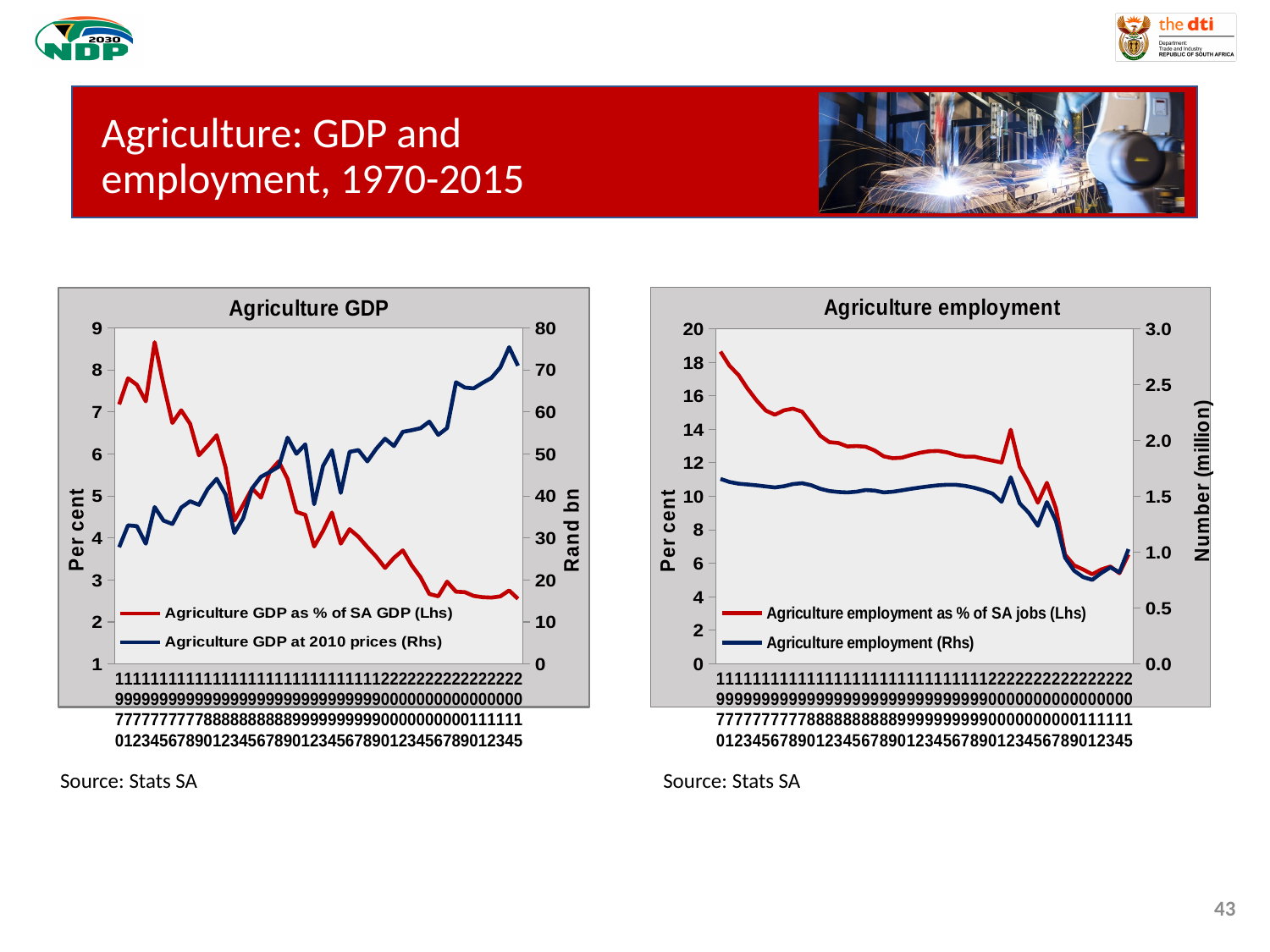
In the 'Agriculture GDP' chart, is the value of 'Agriculture GDP at 2010 prices (Rhs)' in 2015 greater or less than 60? greater How many series does the legend of the 'Agriculture GDP' chart list? 2 In the 'Agriculture employment' chart, does the 'Agriculture employment as % of SA jobs (Lhs)' series generally rise or fall from 1970 to 2015? Fall In the 'Agriculture GDP' chart, does the 'Agriculture GDP at 2010 prices (Rhs)' series generally rise or fall from 1970 to 2015? Rise How many series does the legend of the 'Agriculture employment' chart list? 2 In the 'Agriculture employment' chart, is the value of 'Agriculture employment as % of SA jobs (Lhs)' in 2015 greater or less than 8? less In the 'Agriculture GDP' chart, does the 'Agriculture GDP as % of SA GDP (Lhs)' series generally rise or fall from 1970 to 2015? Fall What is the title of the right-hand vertical axis of the 'Agriculture employment' chart? Number (million) In the 'Agriculture employment' chart, is the value of 'Agriculture employment as % of SA jobs (Lhs)' in 1970 greater or less than 16? greater What kind of chart is the 'Agriculture GDP' chart on the left? Line chart What is the title of the right-hand vertical axis of the 'Agriculture GDP' chart? Rand bn